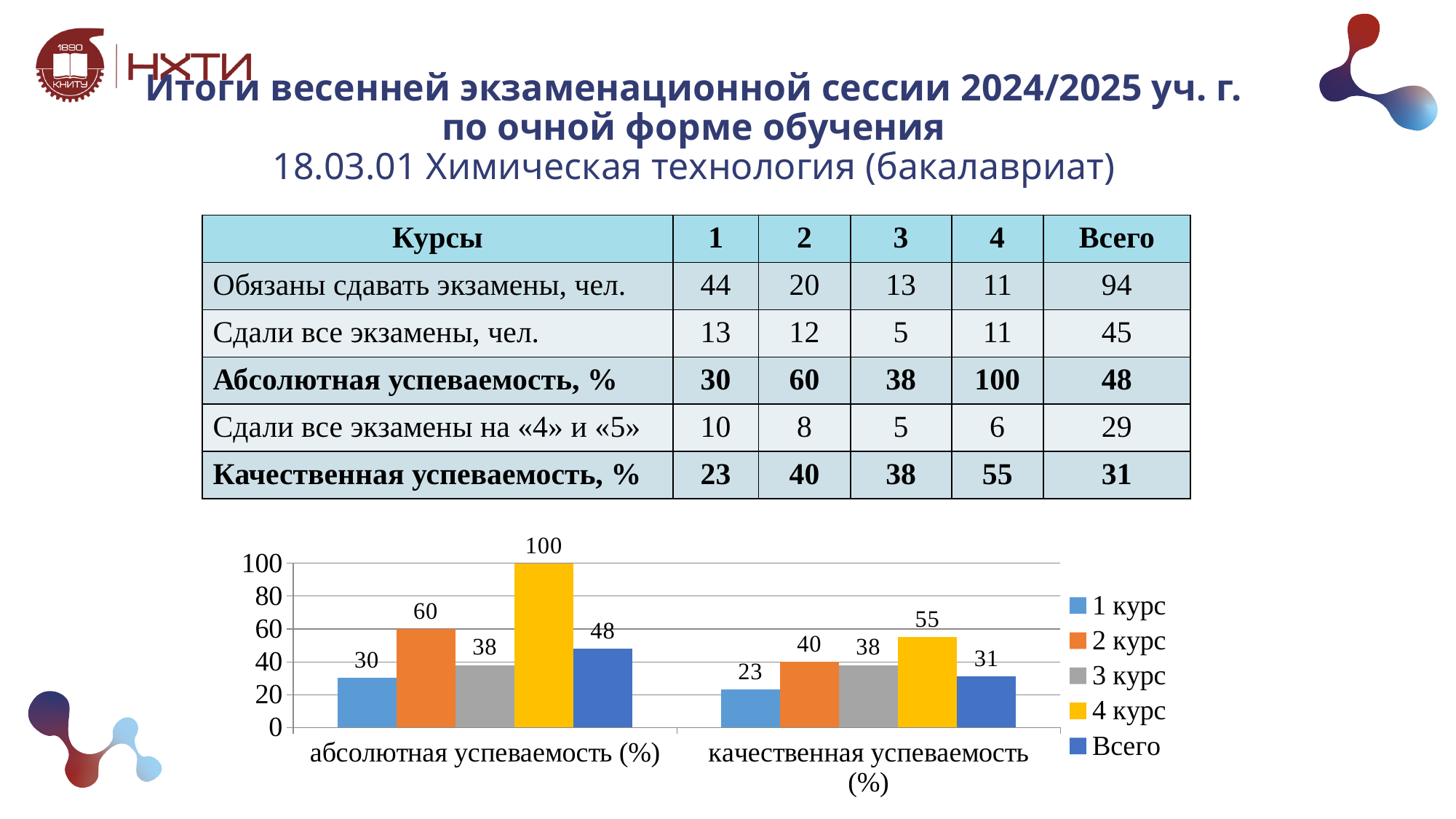
What is the value for Всего in the абсолютная успеваемость (%) category? 48 How many series does the chart legend list? 5 What is the difference between the 4 курс and 2 курс values in the абсолютная успеваемость (%) category? 40 What colour are the bars for 4 курс in the chart? yellow How many categories are shown on the x axis of the chart? 2 Which series has the highest value in the качественная успеваемость (%) category? 4 курс What is the value for 4 курс in the абсолютная успеваемость (%) category? 100 What is the value for 1 курс in the качественная успеваемость (%) category? 23 Which series has the lowest value in the абсолютная успеваемость (%) category? 1 курс Which is larger: the 2 курс value for абсолютная успеваемость (%) or the 2 курс value for качественная успеваемость (%)? абсолютная успеваемость (%) Is the value for 3 курс in the качественная успеваемость (%) category greater or less than 40? less What kind of chart is shown on the slide? bar chart